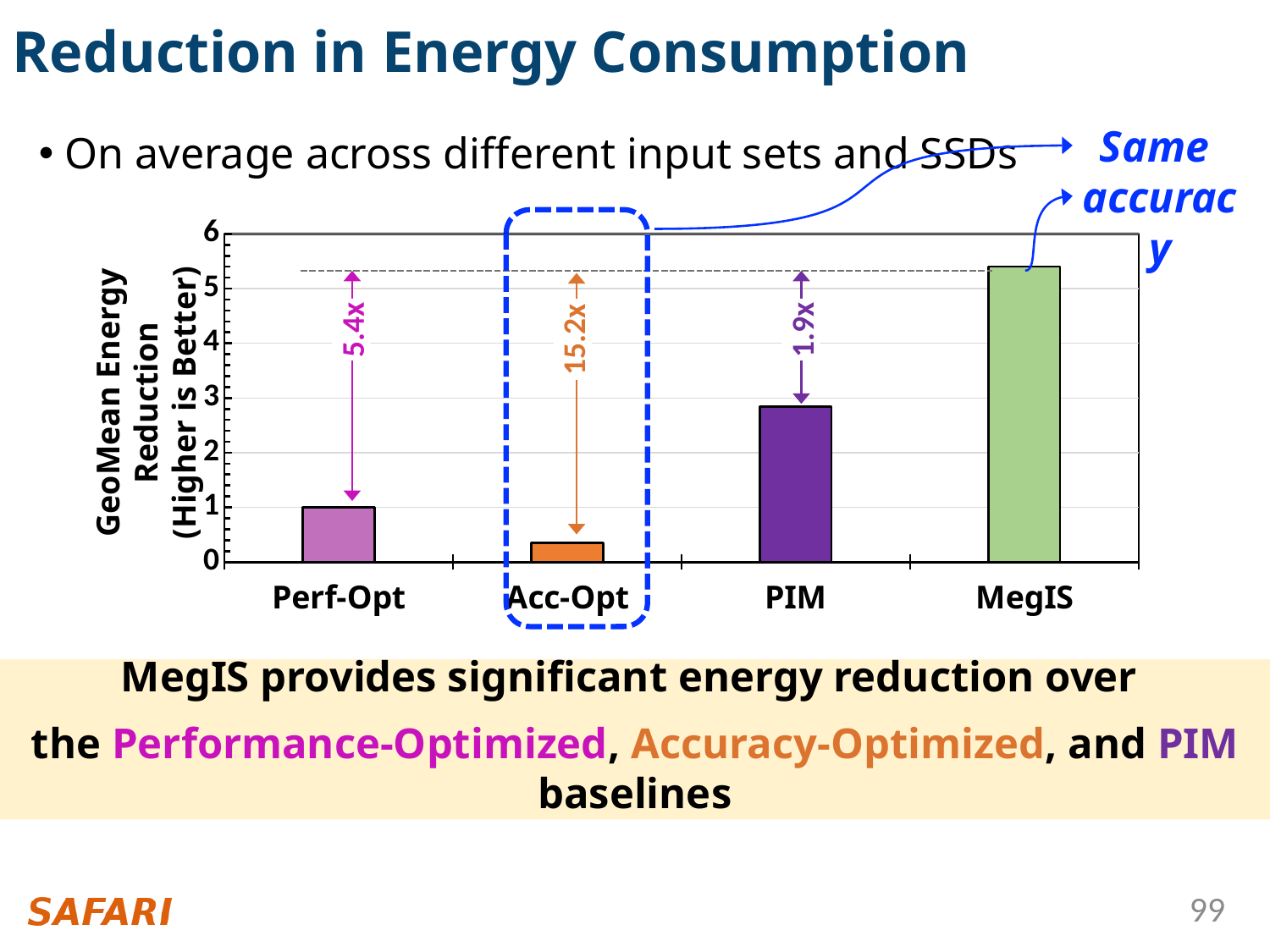
What is the GeoMean Energy Reduction value for Perf-Opt? 1 What kind of chart is shown on the slide? bar chart Is the value for PIM greater or less than 3? less Which category has the lowest GeoMean Energy Reduction? Acc-Opt What improvement factor is annotated above the PIM bar? 1.9x What is the label of the y axis? GeoMean Energy Reduction (Higher is Better) Which category has the highest GeoMean Energy Reduction? MegIS Is the value for Acc-Opt greater or less than 1? less Which has a larger GeoMean Energy Reduction, PIM or Perf-Opt? PIM How many categories are shown on the x axis of the chart? 4 Is the value for MegIS greater or less than 5? greater What improvement factor is annotated above the Acc-Opt bar? 15.2x